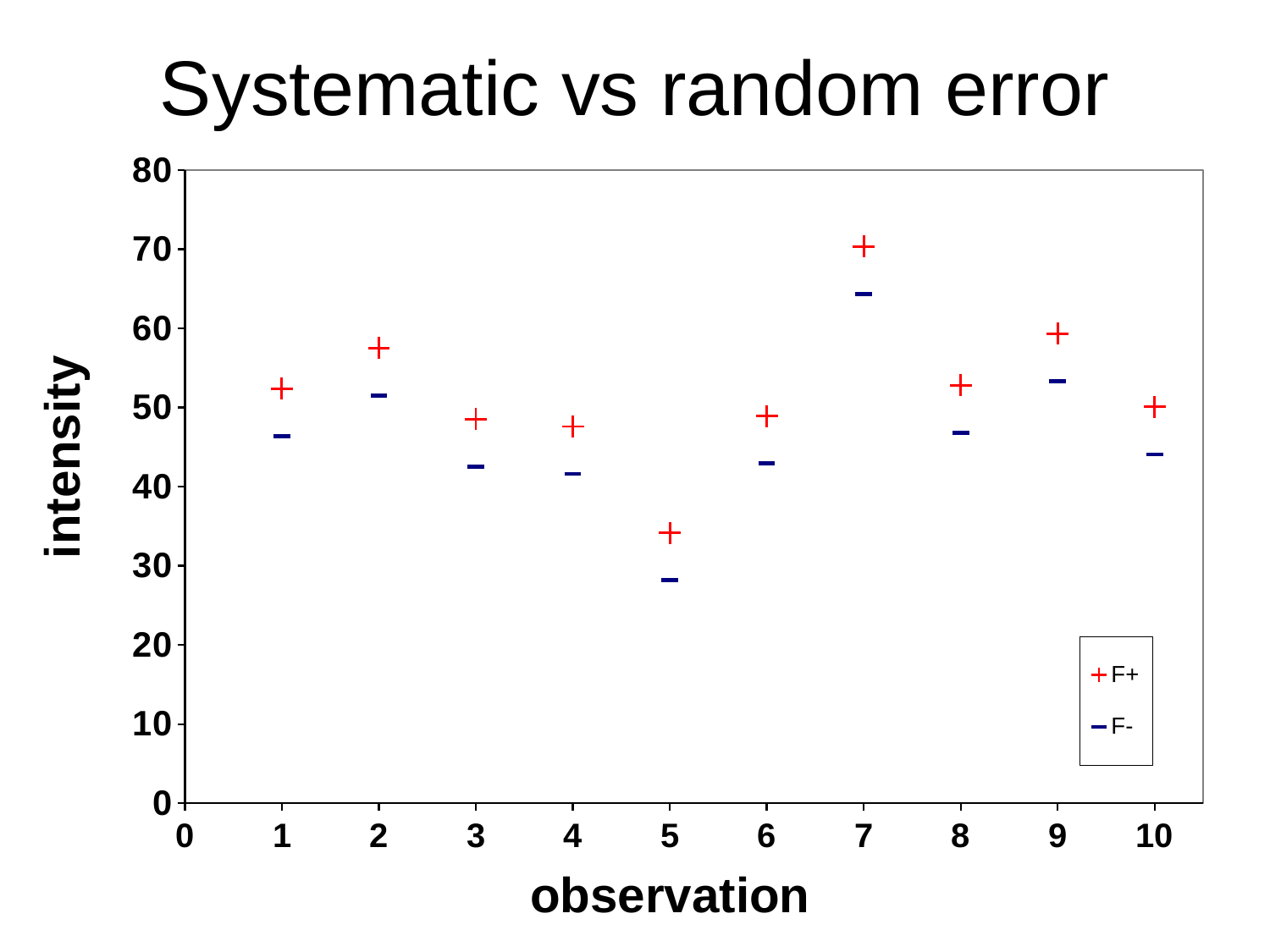
Which is larger, the F+ value at observation 2 or the F+ value at observation 3? observation 2 What is the label of the y axis? intensity At which observation is the F- intensity lowest? 5 How many series does the legend list? 2 Is the F+ value at observation 7 greater or less than 60? greater Is the F- value at observation 1 greater or less than 50? less At which observation is the F+ intensity highest? 7 What kind of chart is shown on the slide? scatter chart Is the F- value at observation 5 greater or less than 30? less At observation 1, which series has the larger intensity, F+ or F-? F+ How many observations are plotted for each series? 10